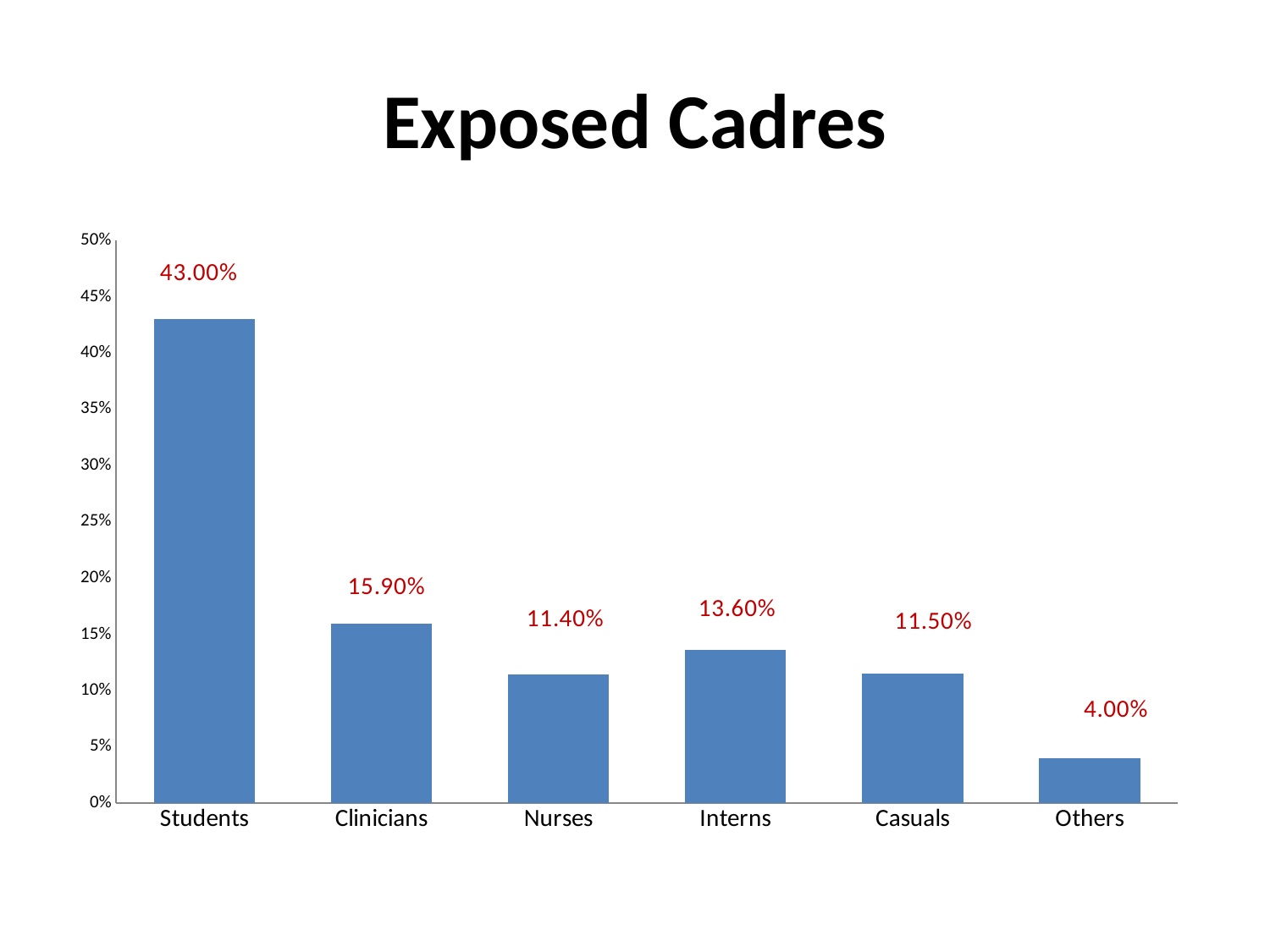
Which is larger, the value for Clinicians or the value for Interns? Clinicians What is the value for Others? 4.00% Which category has the highest value? Students What is the difference between the values for Interns and Nurses? 2.20% What kind of chart is shown on the slide? bar chart What is the difference between the values for Students and Clinicians? 27.10% How many categories are shown on the x axis? 6 What is the value for Clinicians? 15.90% Is the value for Casuals greater or less than 10%? greater What is the value for Interns? 13.60% Which category has the lowest value? Others What is the value for Students? 43.00%